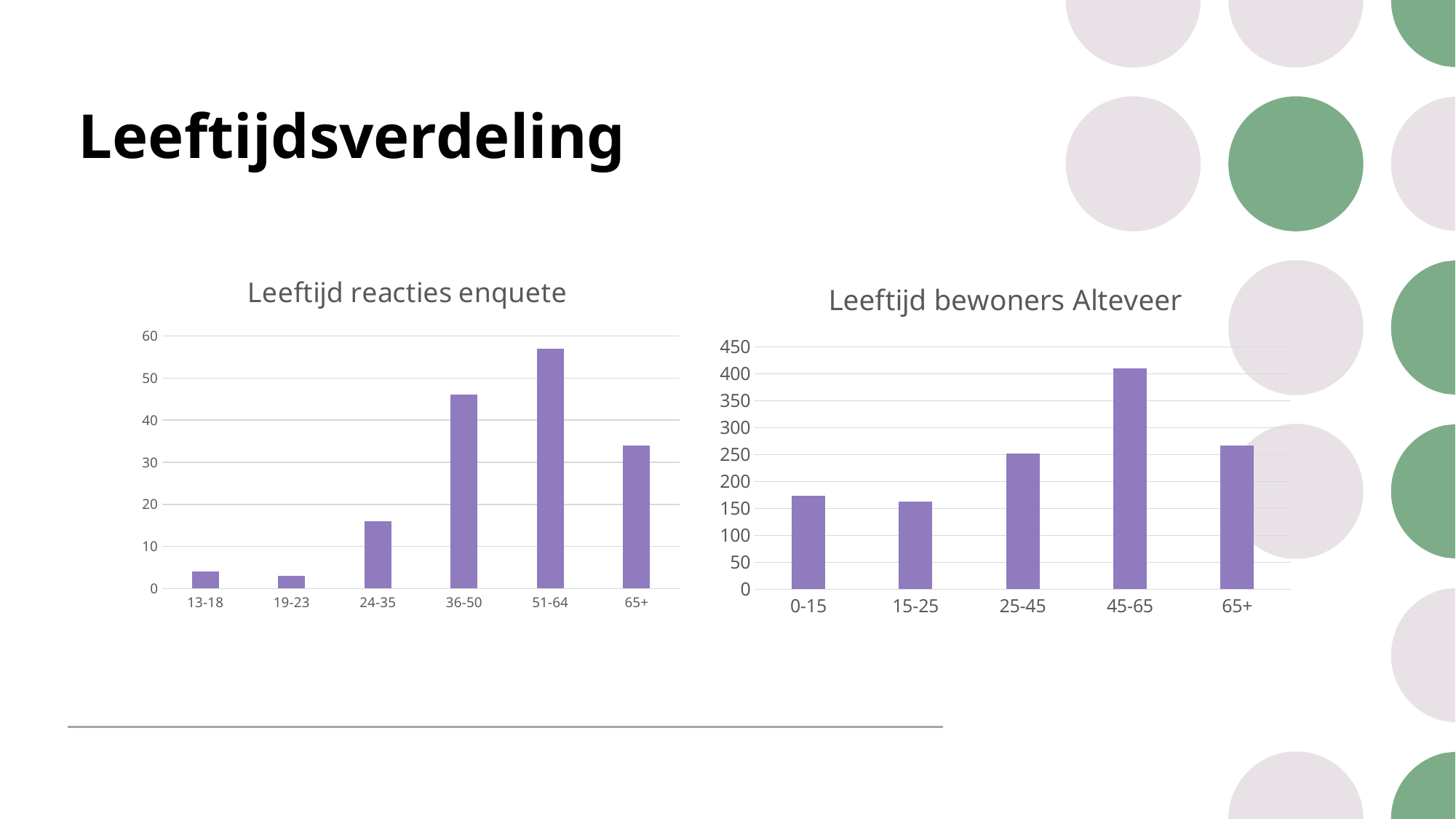
In the chart titled 'Leeftijd reacties enquete', is the value for 36-50 greater or less than 40? greater In the chart titled 'Leeftijd reacties enquete', is the value for 65+ greater or less than 30? greater In the chart titled 'Leeftijd bewoners Alteveer', which age group has the highest value? 45-65 How many age groups are shown in the chart titled 'Leeftijd bewoners Alteveer'? 5 In the chart titled 'Leeftijd bewoners Alteveer', which is larger, the value for 0-15 or the value for 25-45? 25-45 In the chart titled 'Leeftijd reacties enquete', which is larger, the value for 36-50 or the value for 65+? 36-50 What kind of chart is the chart on the right of the slide? Bar chart In the chart titled 'Leeftijd reacties enquete', is the value for 24-35 greater or less than 20? less In the chart titled 'Leeftijd reacties enquete', which age group has the highest value? 51-64 How many age groups are shown in the chart titled 'Leeftijd reacties enquete'? 6